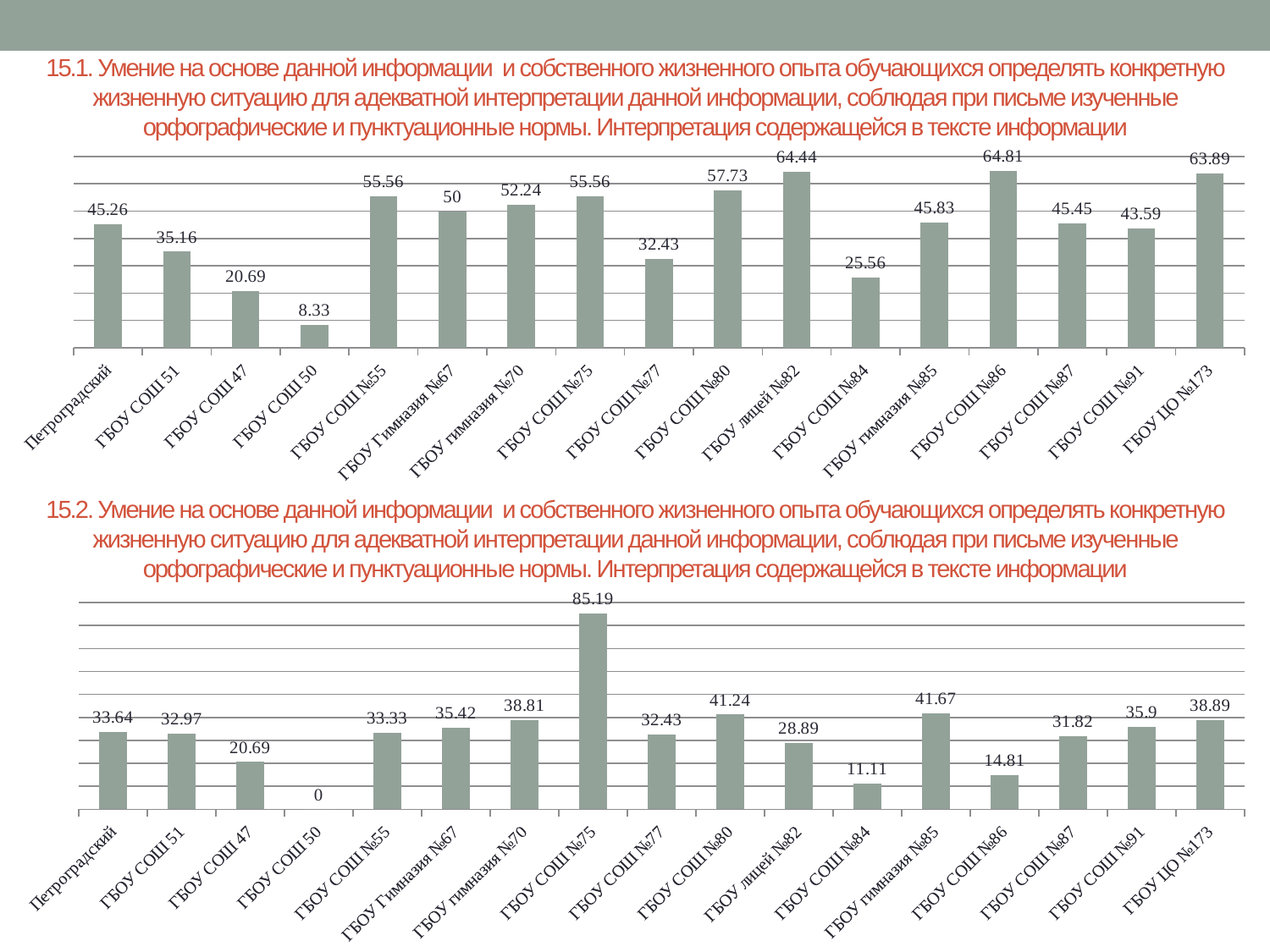
In the top chart (15.1), which school has the highest value? ГБОУ СОШ №86 In the bottom chart (15.2), what is the difference between the values for ГБОУ СОШ №86 and ГБОУ СОШ №84? 3.7 In the top chart (15.1), what is the value for ГБОУ лицей №82? 64.44 In the bottom chart (15.2), which school has the lowest value? ГБОУ СОШ 50 In the top chart (15.1), which school has the lowest value? ГБОУ СОШ 50 In the bottom chart (15.2), which is larger: the value for ГБОУ гимназия №85 or ГБОУ СОШ №80? ГБОУ гимназия №85 What type of chart is the top chart (15.1)? Bar chart In the top chart (15.1), what is the difference between the values for ГБОУ СОШ №80 and ГБОУ СОШ №77? 25.3 How many schools (categories) are shown in the bottom chart (15.2)? 17 In the top chart (15.1), what is the value for Петроградский? 45.26 In the bottom chart (15.2), what is the value for ГБОУ СОШ №84? 11.11 In the bottom chart (15.2), what is the value for ГБОУ СОШ №75? 85.19